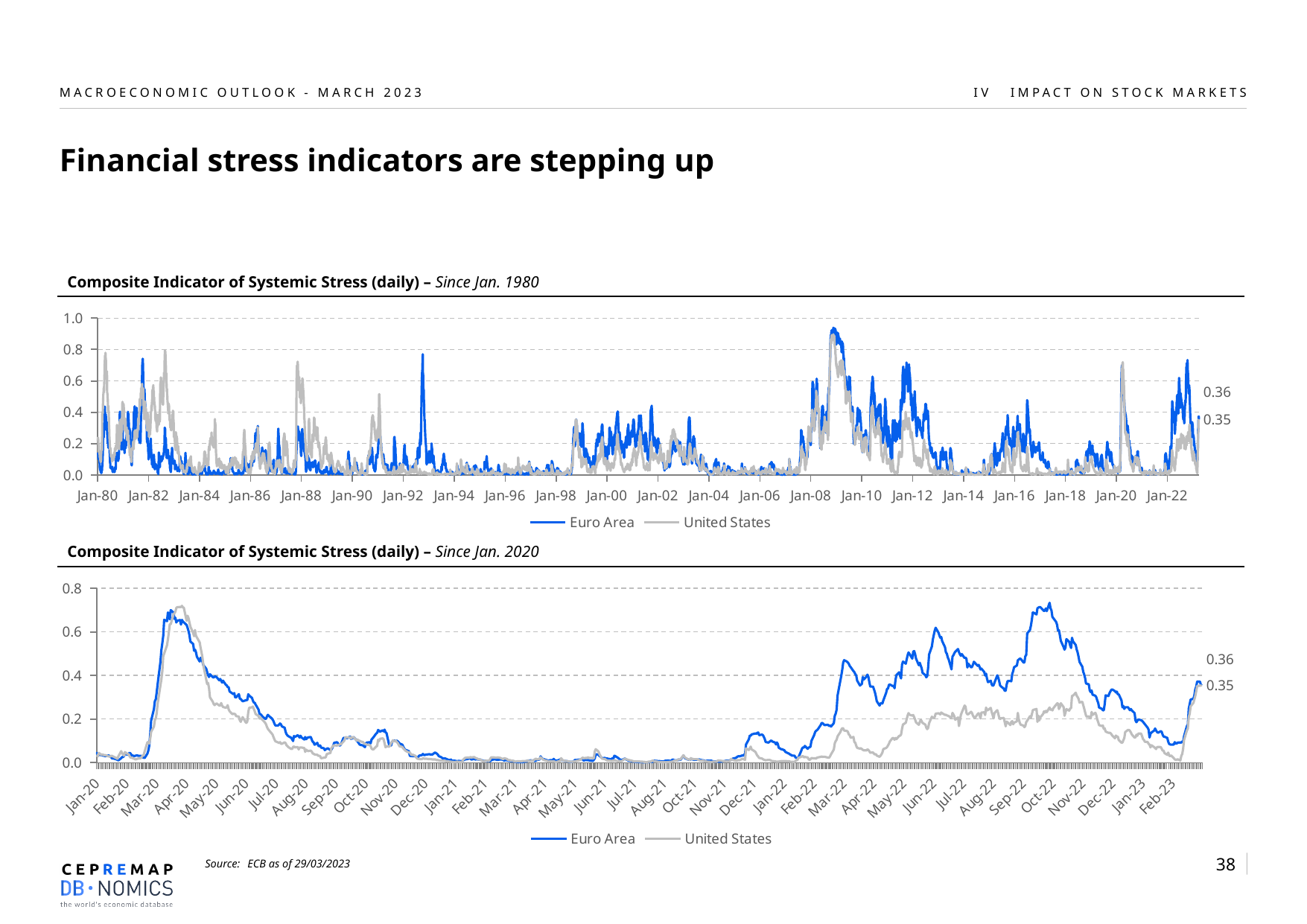
In the bottom chart, 'Since Jan. 2020', does the Euro Area series rise or fall between Oct-22 and Jan-23? fall In the top chart, 'Since Jan. 1980', is the peak value of the Euro Area series around Jan-08 to Jan-10 greater or less than 0.8? greater Which two series are listed in the legend of the top chart, 'Since Jan. 1980'? Euro Area and United States In the top chart, 'Since Jan. 1980', is the Euro Area spike around Jan-92 to Jan-94 greater or less than 0.6? greater What two values are labelled at the right end of the bottom chart, 'Since Jan. 2020'? 0.36 and 0.35 In the bottom chart, 'Since Jan. 2020', does the Euro Area series rise or fall from Jan-23 to the end of the series? rise In the bottom chart, 'Since Jan. 2020', which series is higher around Oct-22, Euro Area or United States? Euro Area In the bottom chart, 'Since Jan. 2020', is the peak of the United States series around Apr-20 greater or less than 0.6? greater What source is cited for the charts on the slide? ECB as of 29/03/2023 What type of chart is the top chart, 'Composite Indicator of Systemic Stress (daily) – Since Jan. 1980'? Line chart How many series does the legend of the bottom chart, 'Since Jan. 2020', list? 2